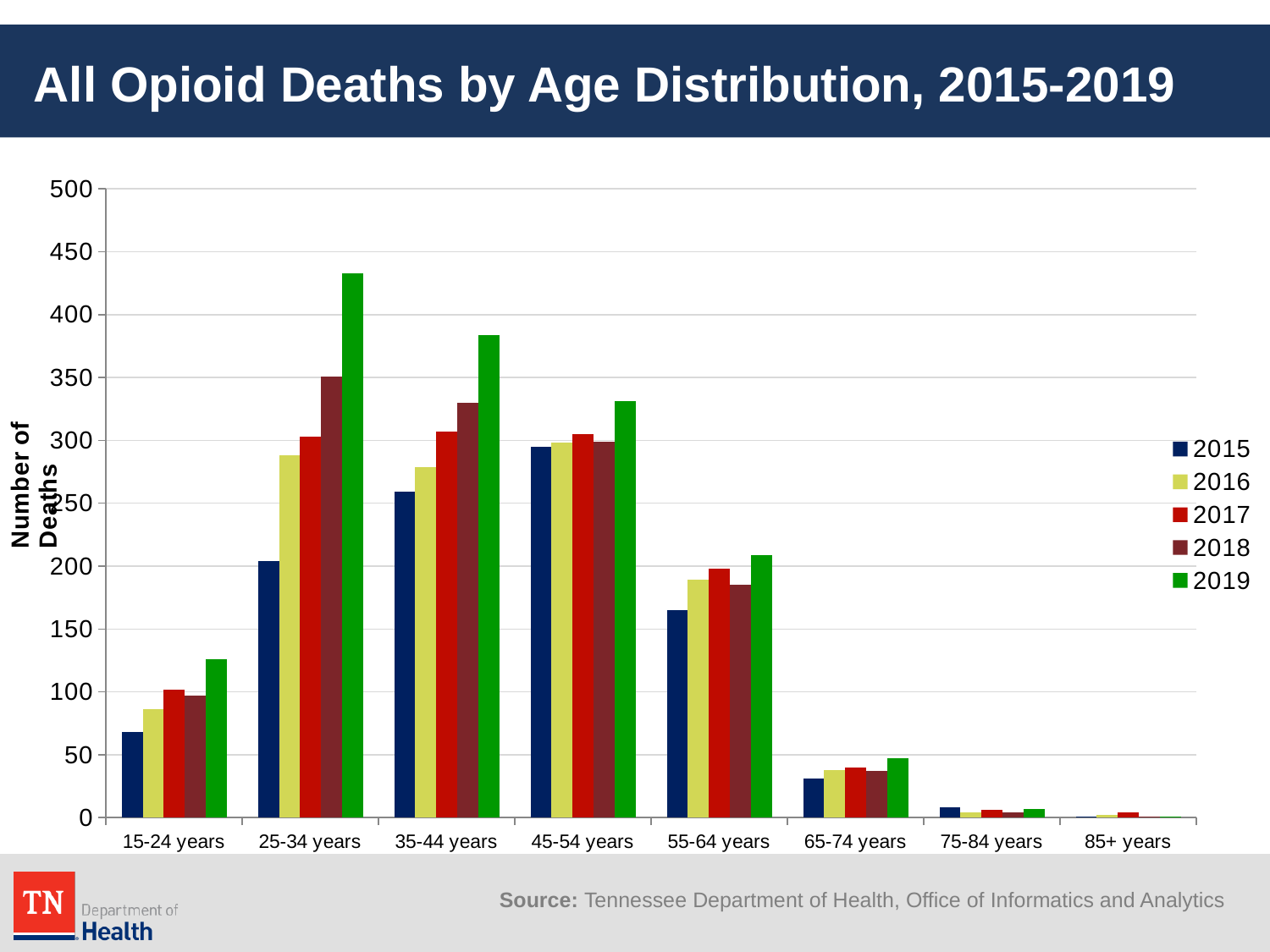
How many series does the legend list? 5 Is the value for 2015 in the 25-34 years group greater or less than 250? less Is the value for 2015 in the 55-64 years group greater or less than 200? less Is the value for 2019 in the 25-34 years group greater or less than 400? greater In the 15-24 years group, which year has more deaths: 2015 or 2019? 2019 For 2019, which age group has more deaths: 35-44 years or 45-54 years? 35-44 years In the 25-34 years group, do the values rise or fall from 2015 to 2019? rise How many age groups are shown on the x axis? 8 What kind of chart is shown on the slide? bar chart Which age group has the highest number of deaths for 2019? 25-34 years What is the title of the y axis? Number of Deaths Which age group has the lowest number of deaths across all years? 85+ years